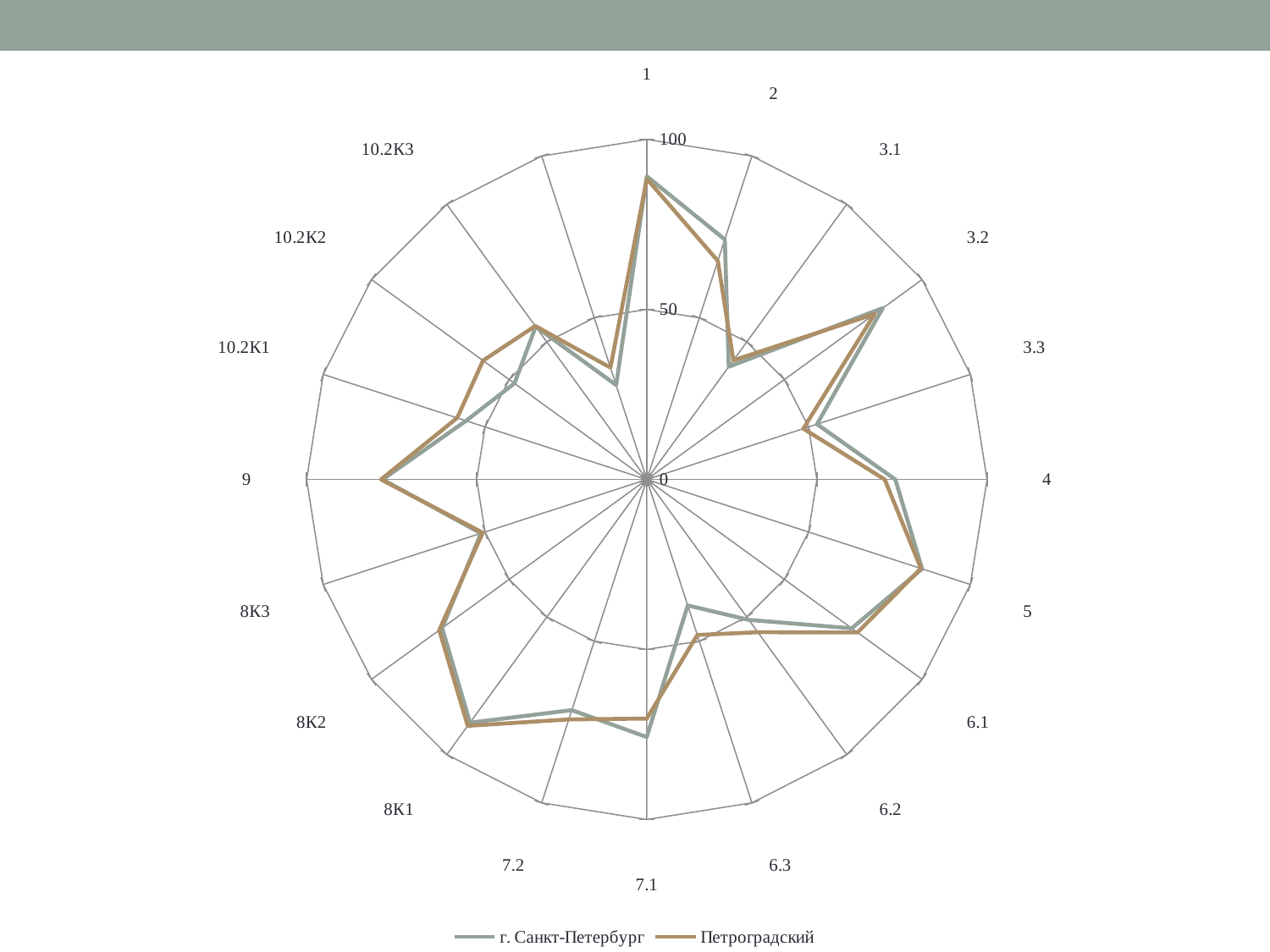
Is the value for category 5 greater or less than 50? greater Is the value for category 3.1 greater or less than 50? less Is the value for category 8К2 greater or less than 50? greater What kind of chart is shown on the slide? Radar chart Which has the larger value, category 8К2 or category 3.1? 8К2 What are the two series named in the legend? г. Санкт-Петербург and Петроградский Which has the larger value, category 9 or category 3.1? 9 How many series does the legend list? 2 What is the highest value marked on the radial axis? 100